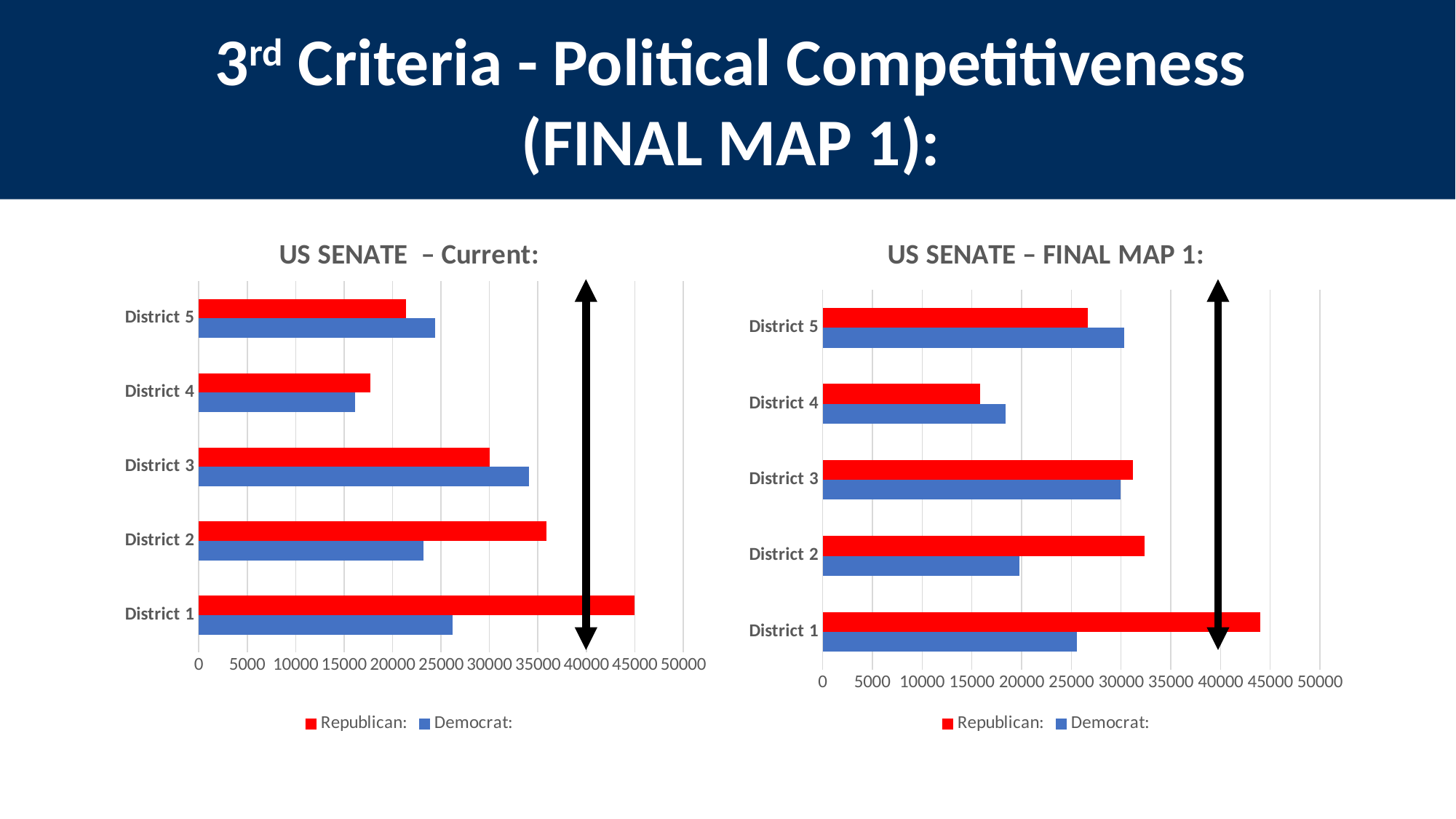
What kind of chart is the 'US SENATE – Current:' chart? bar chart How many districts are shown on the 'US SENATE – Current:' chart? 5 In the 'US SENATE – Current:' chart, which district has the highest Republican value? District 1 In the 'US SENATE – FINAL MAP 1:' chart, is the Republican value for District 1 greater or less than 40000? greater How many series does the legend of the 'US SENATE – FINAL MAP 1:' chart list? 2 In the 'US SENATE – FINAL MAP 1:' chart, what colour represents the Democrat series? blue In the 'US SENATE – FINAL MAP 1:' chart, for District 2, which is larger: Republican or Democrat? Republican In the 'US SENATE – Current:' chart, for District 3, which is larger: Republican or Democrat? Democrat In the 'US SENATE – FINAL MAP 1:' chart, which district has the lowest Democrat value? District 4 In the 'US SENATE – Current:' chart, is the Democrat value for District 4 greater or less than 20000? less In the 'US SENATE – Current:' chart, is the Republican value for District 1 greater or less than 40000? greater In the 'US SENATE – Current:' chart, which district has the lowest Republican value? District 4